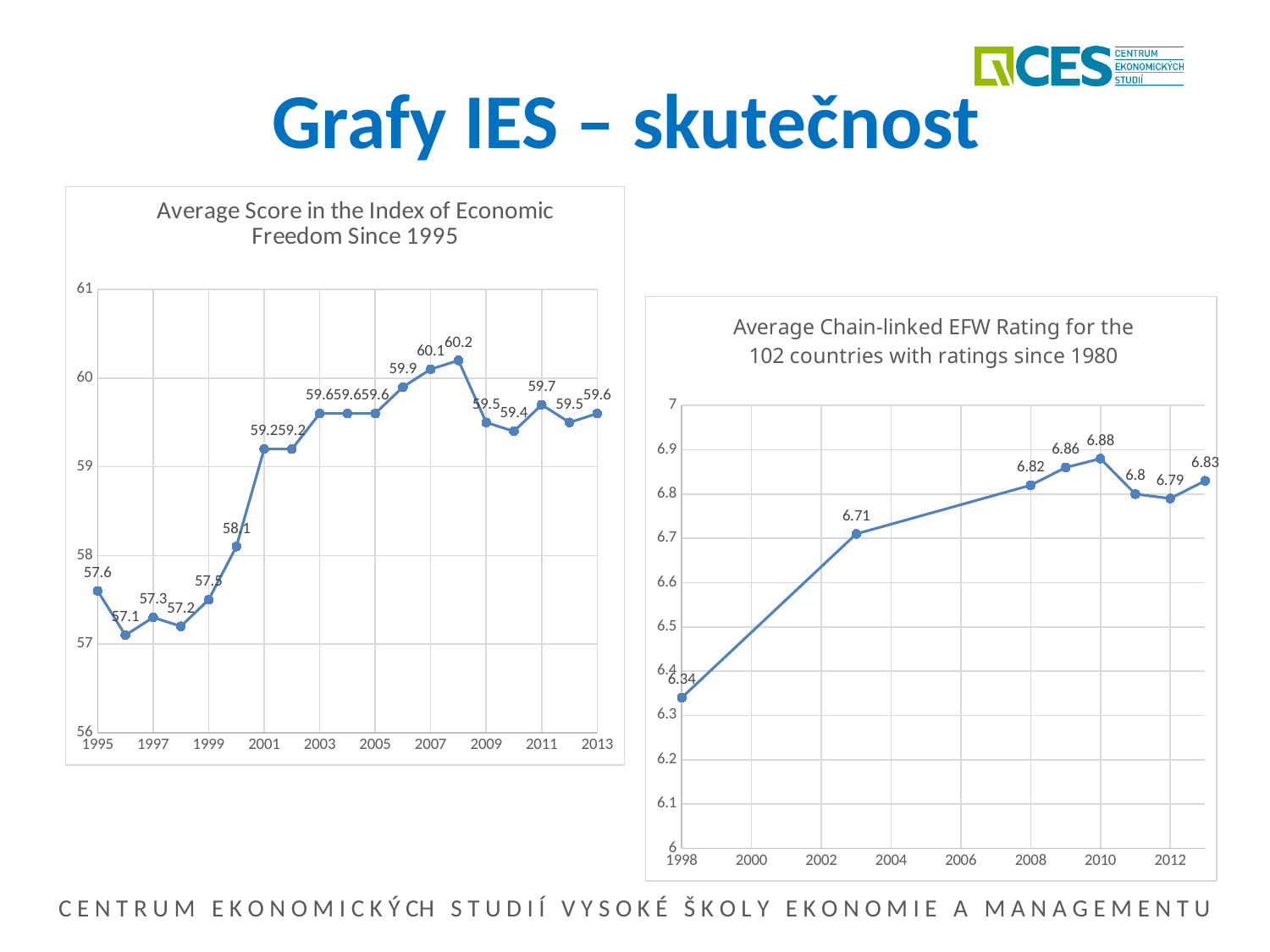
In the chart titled 'Average Chain-linked EFW Rating for the 102 countries with ratings since 1980', what is the value for 2003? 6.71 In the chart titled 'Average Chain-linked EFW Rating for the 102 countries with ratings since 1980', which is larger, the value for 2009 or the value for 2012? 2009 In the chart titled 'Average Score in the Index of Economic Freedom Since 1995', what is the value for 1995? 57.6 In the chart titled 'Average Chain-linked EFW Rating for the 102 countries with ratings since 1980', how many data points are plotted? 8 In the chart titled 'Average Chain-linked EFW Rating for the 102 countries with ratings since 1980', which year has the lowest value? 1998 In the chart titled 'Average Score in the Index of Economic Freedom Since 1995', which year has the lowest value? 1996 In the chart titled 'Average Chain-linked EFW Rating for the 102 countries with ratings since 1980', what is the difference between the values for 2013 and 1998? 0.49 In the chart titled 'Average Score in the Index of Economic Freedom Since 1995', which year has the highest value? 2008 In the chart titled 'Average Score in the Index of Economic Freedom Since 1995', is the value for 2000 greater or less than 58? greater In the chart titled 'Average Chain-linked EFW Rating for the 102 countries with ratings since 1980', which year has the highest value? 2010 What kind of chart is the chart on the left of the slide? line chart In the chart titled 'Average Score in the Index of Economic Freedom Since 1995', what is the difference between the values for 2008 and 1996? 3.1